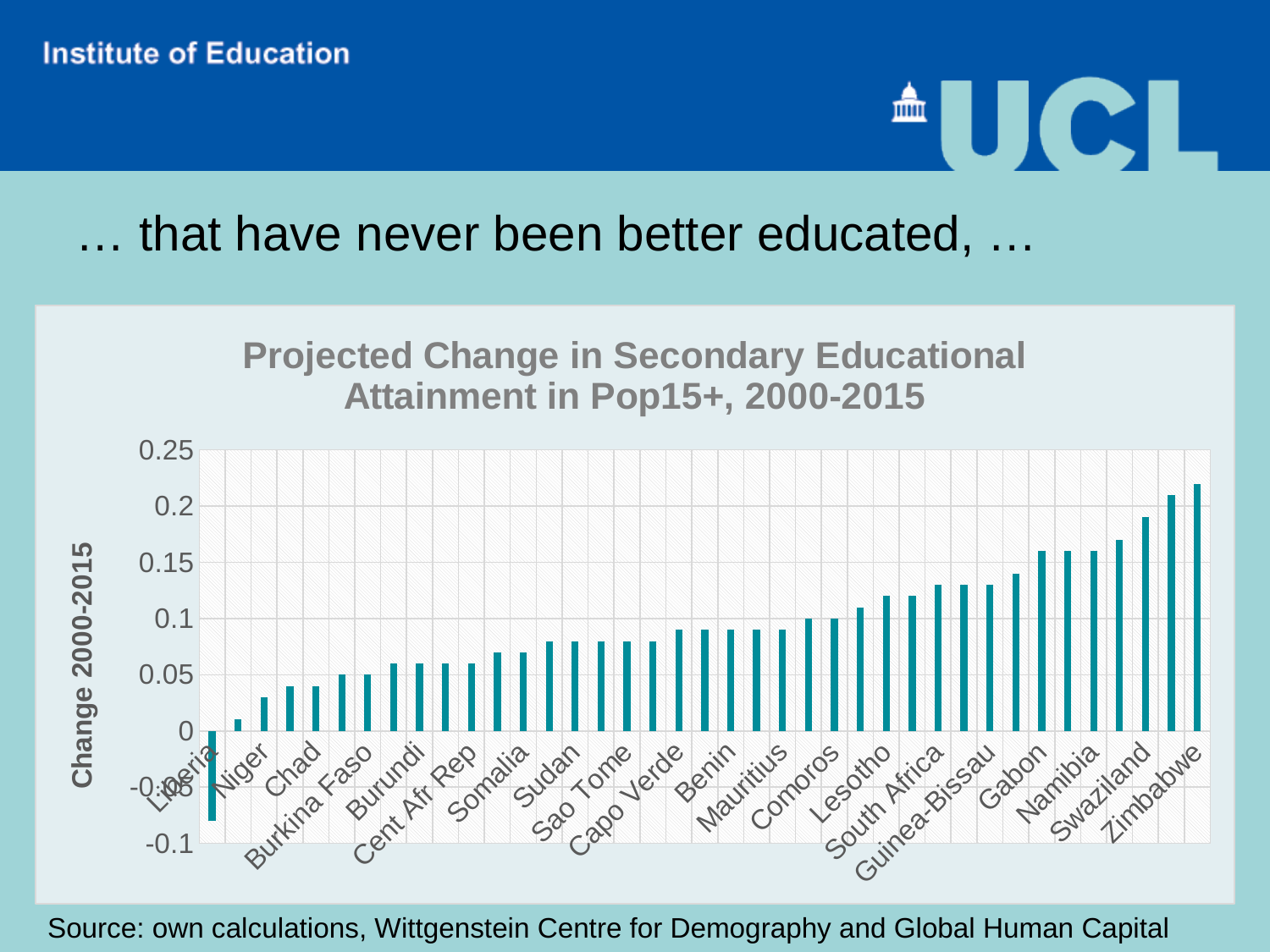
What kind of chart is shown on the slide? bar chart Is the value for South Africa greater or less than 0.1? greater What is the title of the chart? Projected Change in Secondary Educational Attainment in Pop15+, 2000-2015 Do the values generally rise or fall moving from left to right along the x axis? rise Which country has the lowest projected change in the chart? Liberia Is the value for Swaziland greater or less than 0.15? greater Is the value for Liberia greater or less than 0? less Which country has the highest projected change in the chart? Zimbabwe What is the label on the vertical axis of the chart? Change 2000-2015 Which has the larger projected change, Swaziland or Niger? Swaziland